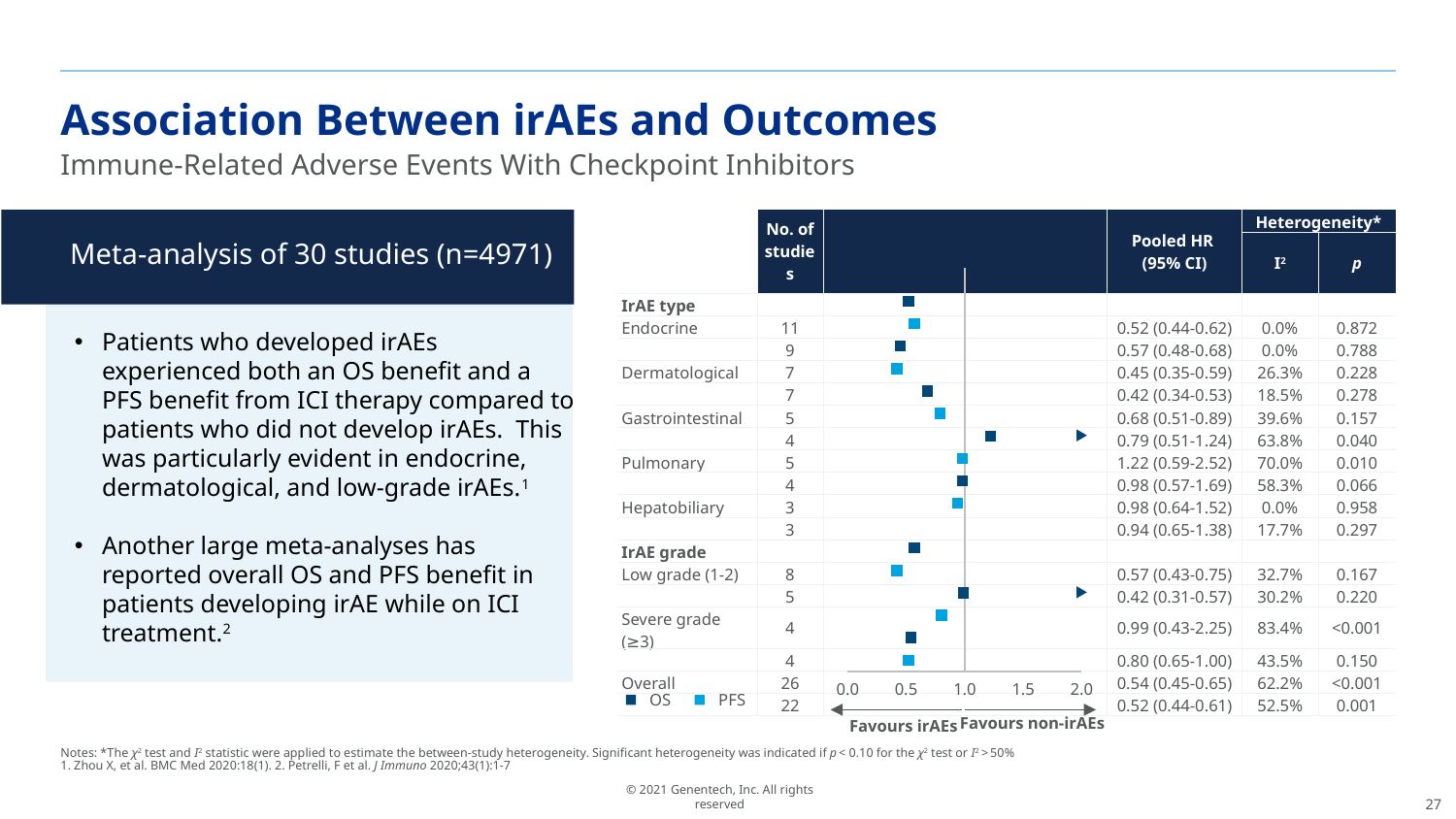
What is the I² value for the OS estimate in the severe grade (≥3) group? 83.4% How many studies contributed to the OS estimate for endocrine irAEs? 11 What label appears at the left end of the x axis of the forest plot? Favours irAEs What kind of chart is shown on the right of the slide? Forest plot Which irAE type has the lowest pooled HR for OS? Dermatological How many series does the legend of the forest plot list? 2 What is the pooled HR (95% CI) for OS in the Overall row? 0.54 (0.45-0.65) In the Overall row, how many more studies contributed to the OS estimate than to the PFS estimate? 4 Which irAE type has the highest pooled HR for OS? Pulmonary How many irAE types are listed in the forest plot? 5 Which has the larger pooled HR for OS: gastrointestinal or hepatobiliary irAEs? Hepatobiliary What is the p value for heterogeneity for the OS estimate in the hepatobiliary group? 0.958